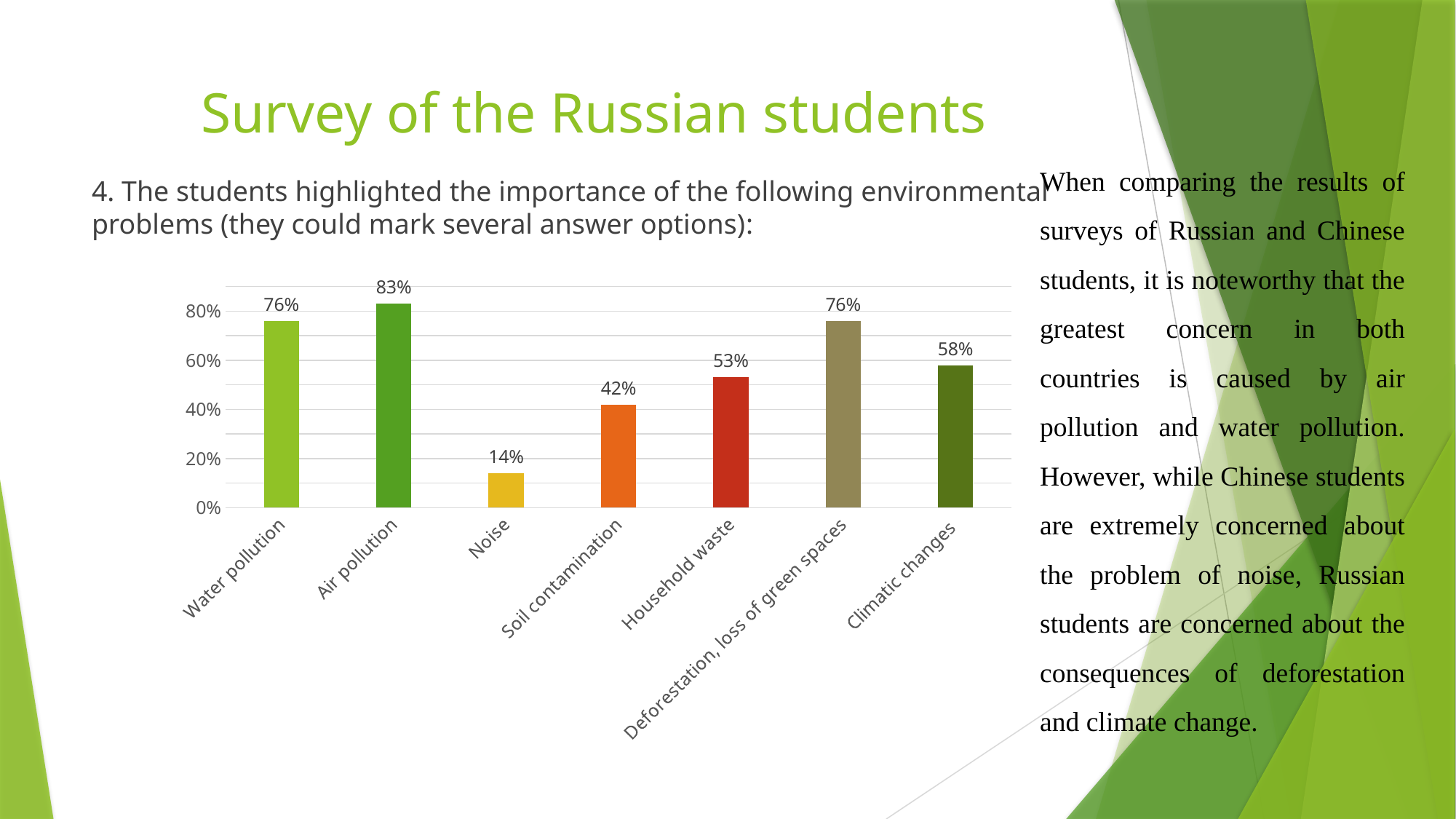
What is the value for Climatic changes? 58% How many environmental problems are shown on the x axis? 7 What percentage is shown for Soil contamination? 42% What percentage of students highlighted Air pollution? 83% What kind of chart is shown on the slide? Bar chart Which two categories share the same value of 76%? Water pollution and Deforestation, loss of green spaces Which is larger, the value for Household waste or the value for Climatic changes? Climatic changes What is the difference between the values for Air pollution and Household waste? 30% Which environmental problem has the lowest percentage? Noise What is the value shown for Noise? 14% Which environmental problem has the highest percentage? Air pollution What is the highest tick label shown on the vertical axis? 80%